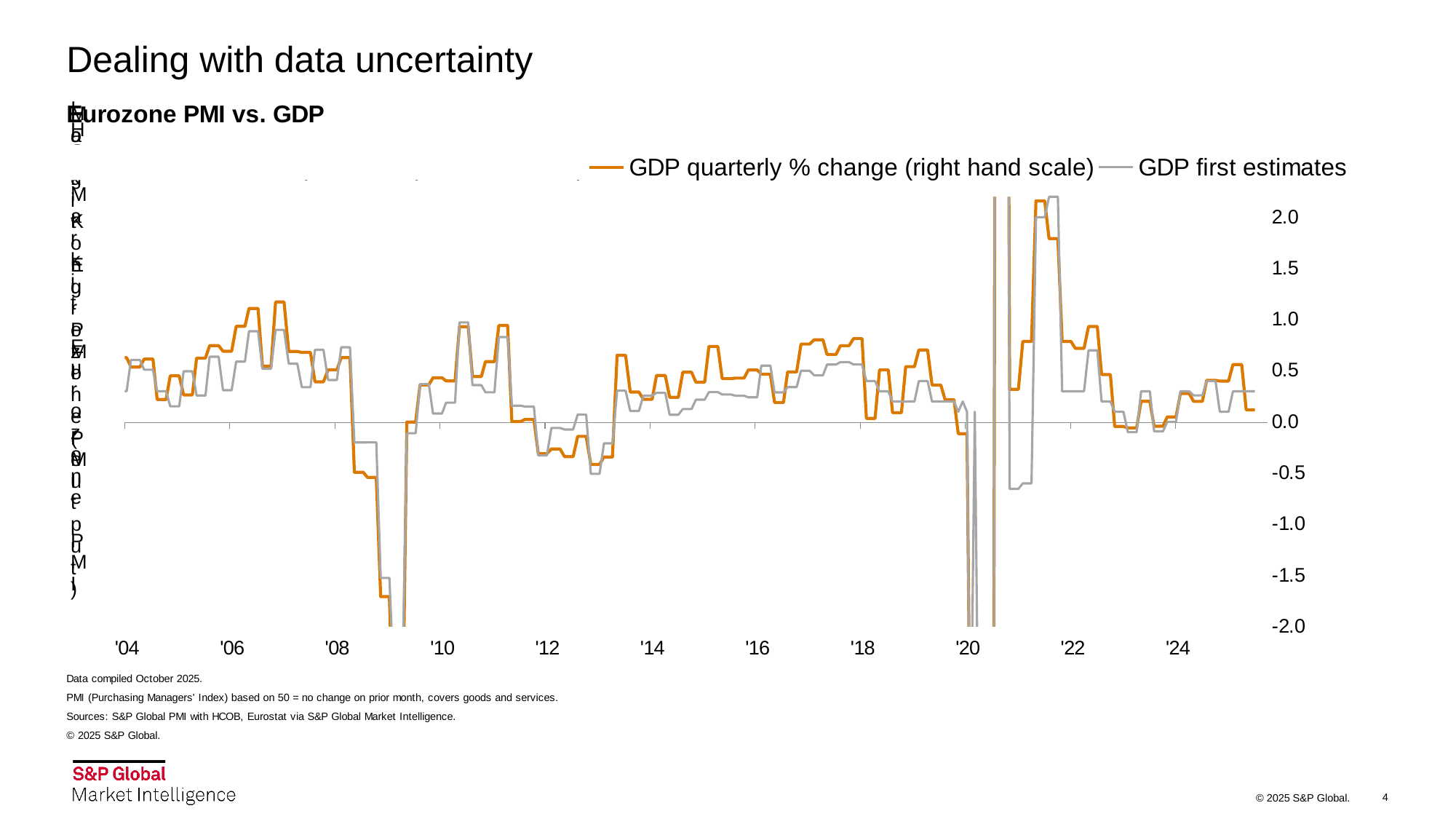
Is the lowest value of the GDP quarterly % change line around 2009 greater or less than -1.0? less Is the peak of the GDP quarterly % change line around 2007 greater or less than 0.5? greater How many series does the chart's legend list? 2 Is the peak of the GDP quarterly % change line in 2021 greater or less than 1.5? greater What is the title of the chart? Eurozone PMI vs. GDP What colour is the line for 'GDP quarterly % change (right hand scale)'? orange Does the GDP quarterly % change line rise or fall from its 2021 peak through 2023? fall What is the first year label on the x axis? '04 How many year labels are shown on the x axis? 11 What kind of chart is shown on the slide? line chart